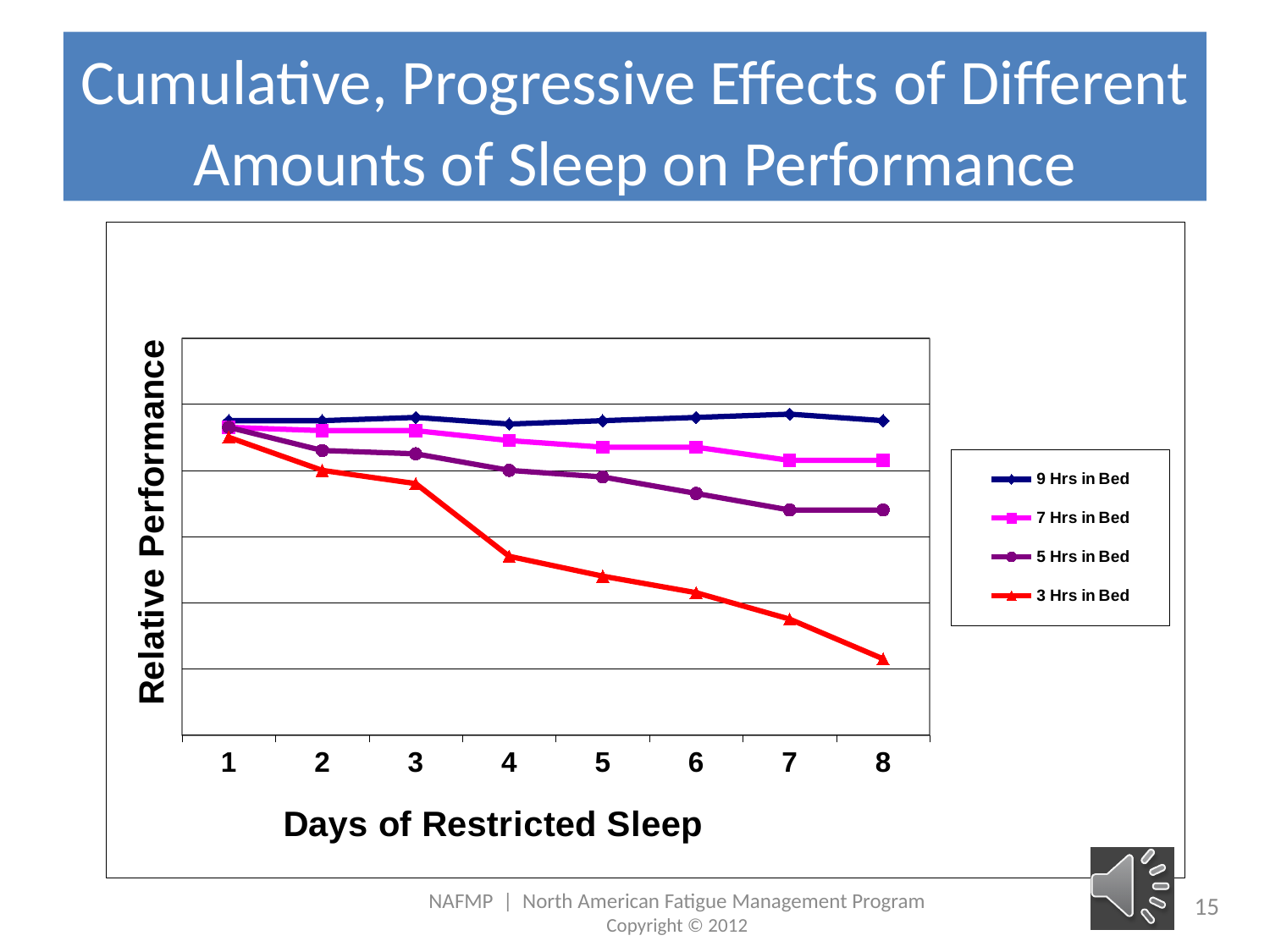
Which series has the highest relative performance on day 8? 9 Hrs in Bed How many series does the legend list? 4 How many days of restricted sleep are plotted along the x axis? 8 What is the title of the y axis? Relative Performance Which series shows the steepest decline in relative performance over the 8 days? 3 Hrs in Bed What kind of chart is shown on the slide? line chart What is the title of the x axis? Days of Restricted Sleep On day 4, which is higher: the relative performance for 7 Hrs in Bed or for 5 Hrs in Bed? 7 Hrs in Bed Does the relative performance for 3 Hrs in Bed rise or fall as the days of restricted sleep increase? fall Which series has the lowest relative performance on day 8? 3 Hrs in Bed On day 6, which is higher: the relative performance for 5 Hrs in Bed or for 3 Hrs in Bed? 5 Hrs in Bed Which series stays roughly flat across the 8 days of restricted sleep? 9 Hrs in Bed